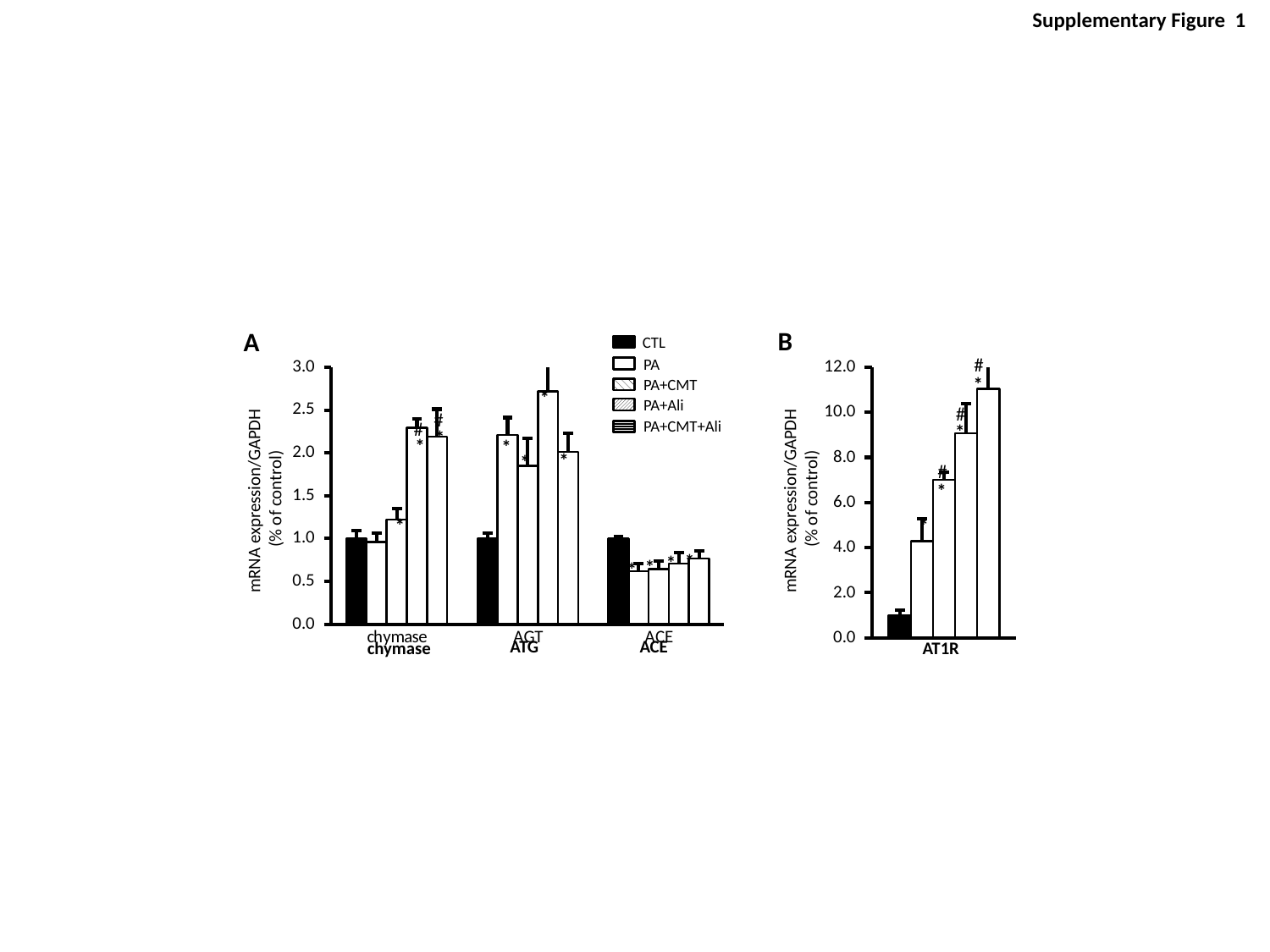
In chart A, is the value for PA+Ali in the ATG category greater or less than 2.5? greater What kind of chart is chart A (the left chart)? bar chart In chart B (AT1R), which series has the lowest bar? CTL How many series does the legend on the slide list? 5 In chart B (AT1R), is the value for PA+CMT+Ali greater or less than 10.0? greater In chart B (AT1R), which series has the highest bar? PA+CMT+Ali In chart B (AT1R), is the value for PA greater or less than 6.0? less In chart B (AT1R), do the bars rise or fall from left to right? rise How many categories are shown on the x axis of chart A (the left chart)? 3 In chart A, in the ACE category, which is larger: CTL or PA? CTL What is the y-axis label of chart B? mRNA expression/GAPDH (% of control)